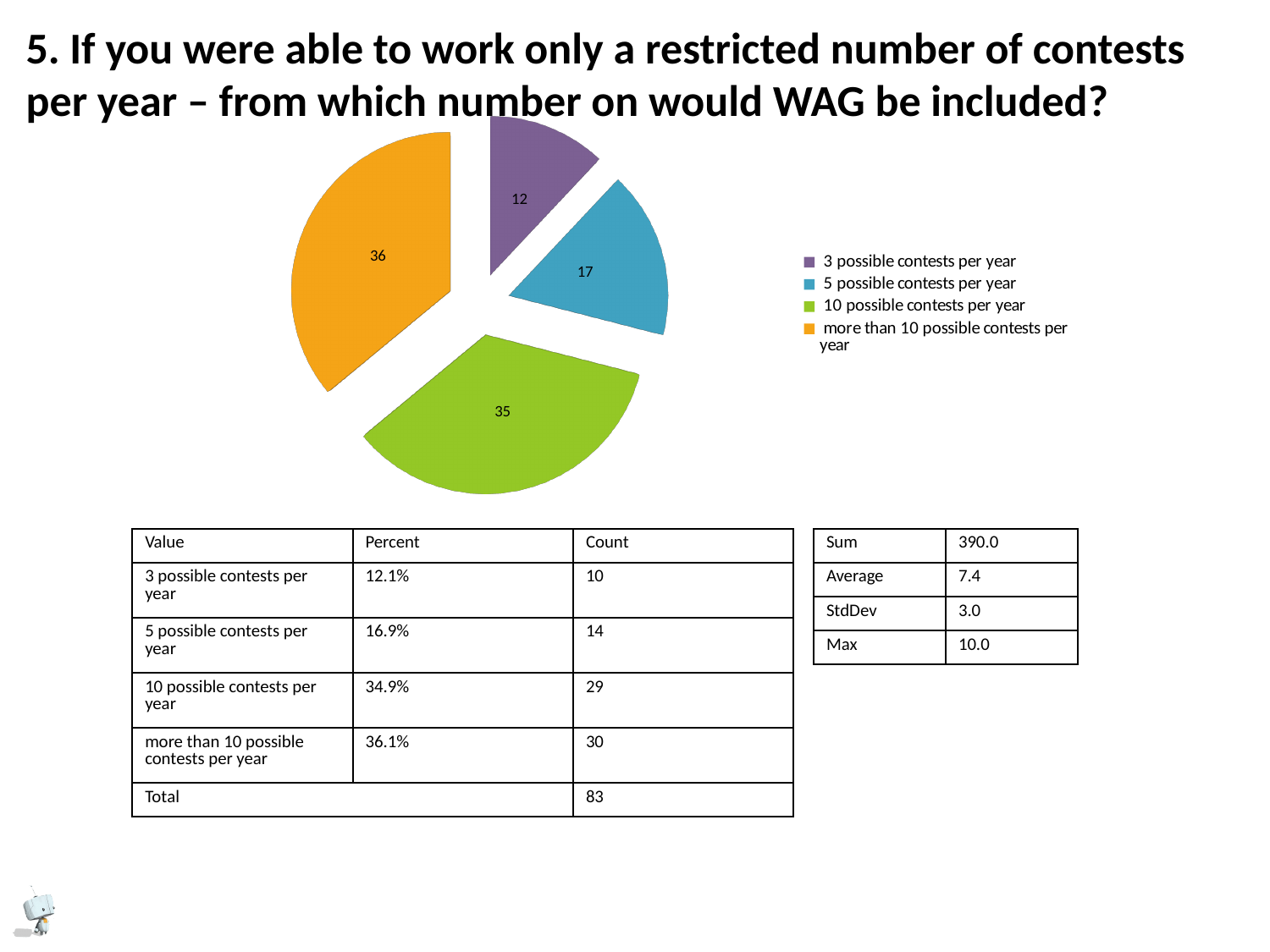
What is the value shown for the 'more than 10 possible contests per year' slice? 36 What is the value shown for the '10 possible contests per year' slice? 35 Which category has the largest slice of the pie? more than 10 possible contests per year What is the value shown for the '3 possible contests per year' slice? 12 What is the value shown for the '5 possible contests per year' slice? 17 What is the difference between the values for '5 possible contests per year' and '3 possible contests per year'? 5 Which category has the smallest slice of the pie? 3 possible contests per year Which is larger: the slice for '10 possible contests per year' or the slice for 'more than 10 possible contests per year'? more than 10 possible contests per year What colour is the slice for '10 possible contests per year'? green What type of chart is shown on the slide? pie chart How many slices does the pie chart have? 4 How many entries does the legend list? 4